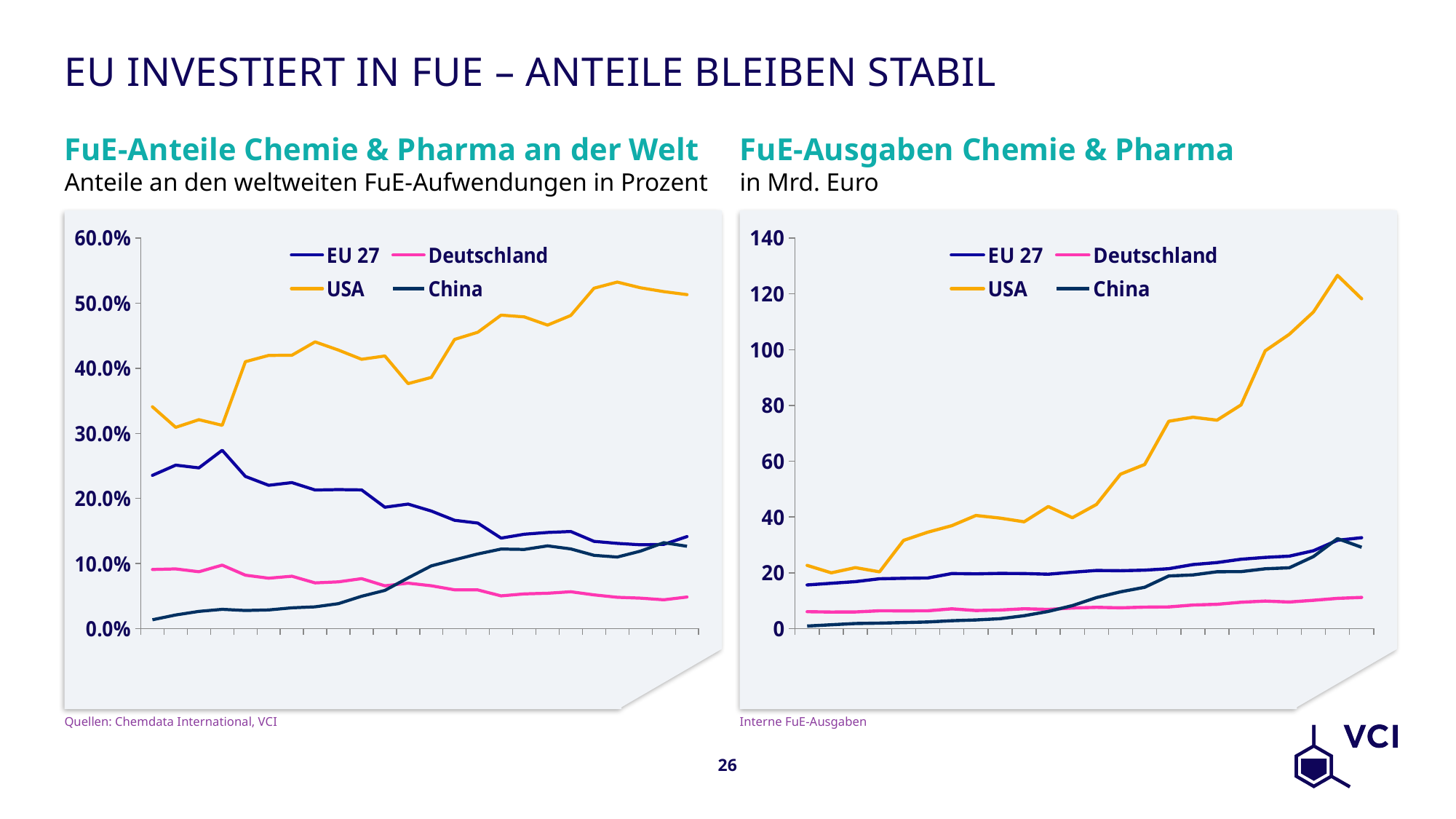
In the left chart, 'FuE-Anteile Chemie & Pharma an der Welt', does the China share rise or fall from left to right? Rise In the left chart, 'FuE-Anteile Chemie & Pharma an der Welt', is the highest value of the USA line greater or less than 50.0%? greater In the right chart, 'FuE-Ausgaben Chemie & Pharma', is the peak value of the USA line greater or less than 120? greater In the left chart, 'FuE-Anteile Chemie & Pharma an der Welt', does the EU 27 share rise or fall from left to right? Fall How many series does the legend of the right chart, 'FuE-Ausgaben Chemie & Pharma', list? 4 In the right chart, 'FuE-Ausgaben Chemie & Pharma', which is larger at the right end of the chart, EU 27 or Deutschland? EU 27 What kind of chart is the left chart, 'FuE-Anteile Chemie & Pharma an der Welt'? Line chart In what unit are the values of the right chart, 'FuE-Ausgaben Chemie & Pharma', given? Mrd. Euro In the right chart, 'FuE-Ausgaben Chemie & Pharma', is the value for Deutschland at the left end of the chart greater or less than 10? less In the left chart, 'FuE-Anteile Chemie & Pharma an der Welt', which series has the lowest share at the right end of the chart? Deutschland In the left chart, 'FuE-Anteile Chemie & Pharma an der Welt', which series has the highest share across the whole chart? USA